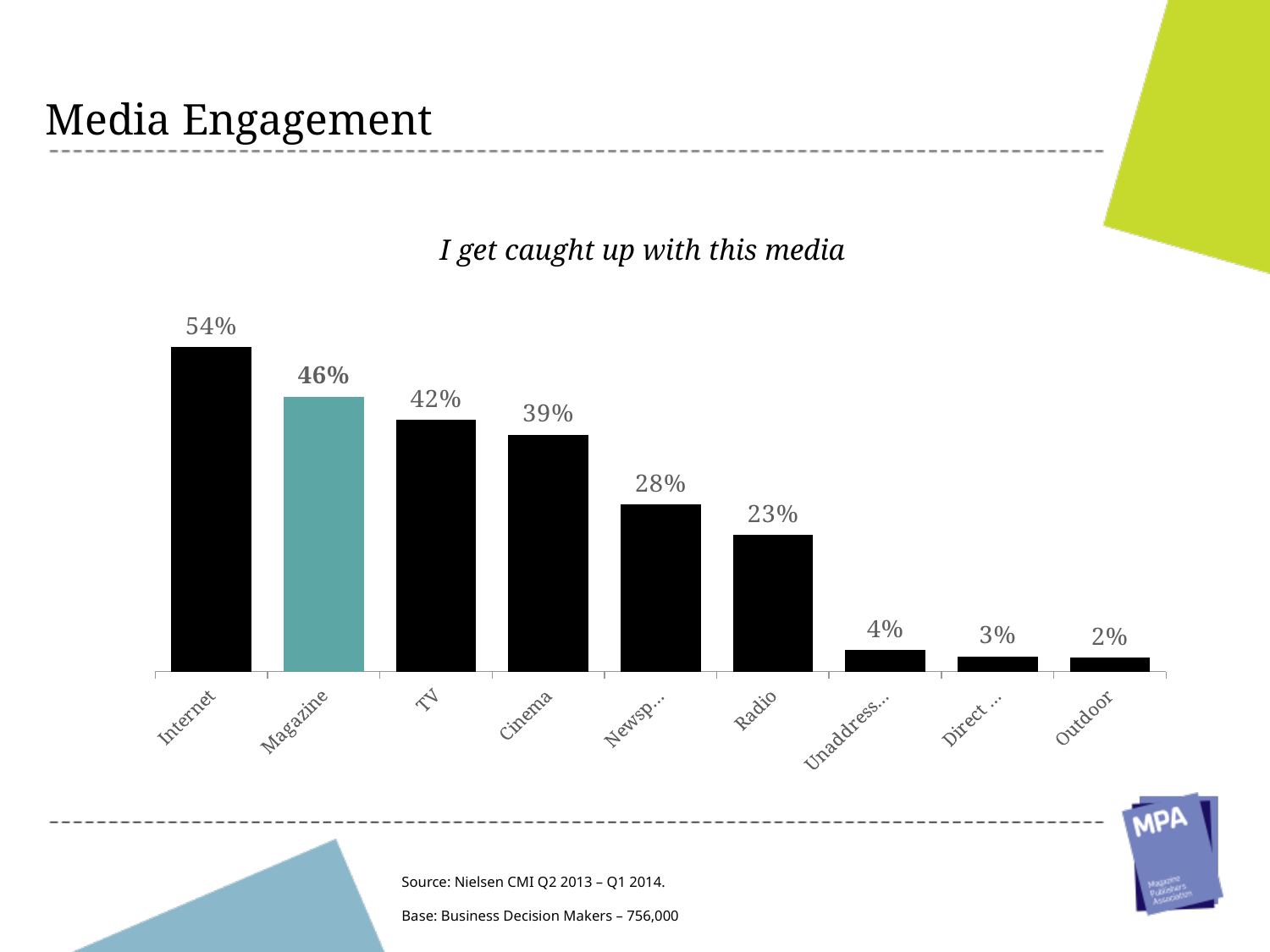
What is the value for Internet? 54% What kind of chart is shown on the slide? Bar chart Which bar is shown in a different colour from the others? Magazine What is the difference between the values for Internet and Magazine? 8% What is the difference between the values for TV and Radio? 19% What is the value for Radio? 23% Which is larger, the value for TV or the value for Cinema? TV What is the value for Cinema? 39% How many categories are shown in the chart? 9 Which category has the highest value? Internet Which category has the lowest value? Outdoor What is the value for Magazine? 46%